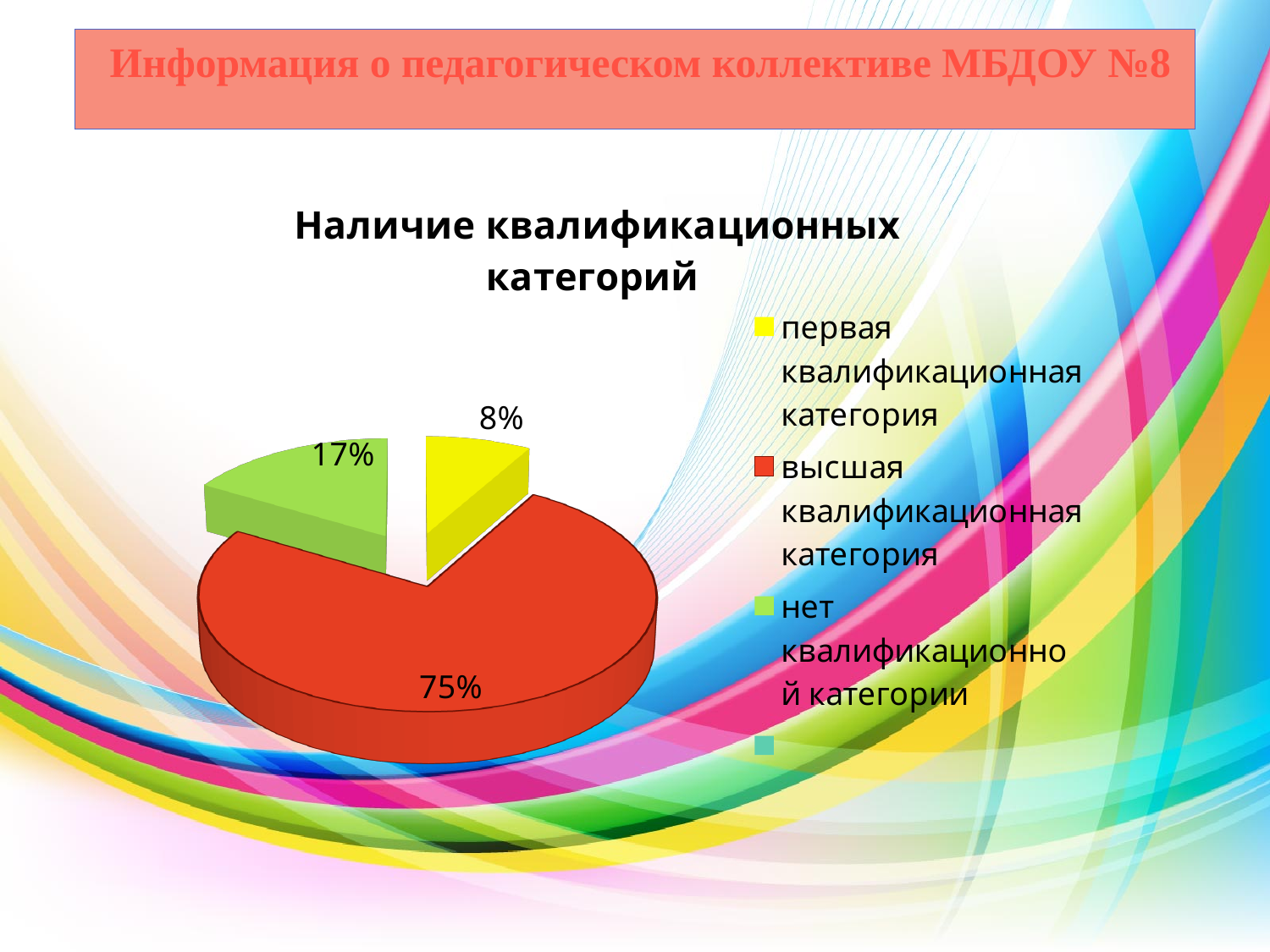
What is the difference in percentage points between the "высшая квалификационная категория" slice and the "нет квалификационной категории" slice? 58 What type of chart is shown on the slide? pie chart What percentage of the pie is labelled for "нет квалификационной категории"? 17% Which category has the smallest slice of the pie? первая квалификационная категория What colour is the slice for "высшая квалификационная категория"? red What percentage of the pie is labelled for "высшая квалификационная категория"? 75% What is the title of the chart? Наличие квалификационных категорий What is the difference in percentage points between the "нет квалификационной категории" slice and the "первая квалификационная категория" slice? 9 What percentage of the pie is labelled for "первая квалификационная категория"? 8% Which category has the largest slice of the pie? высшая квалификационная категория Which slice is larger: "нет квалификационной категории" or "первая квалификационная категория"? нет квалификационной категории How many slices with data labels does the pie chart have? 3